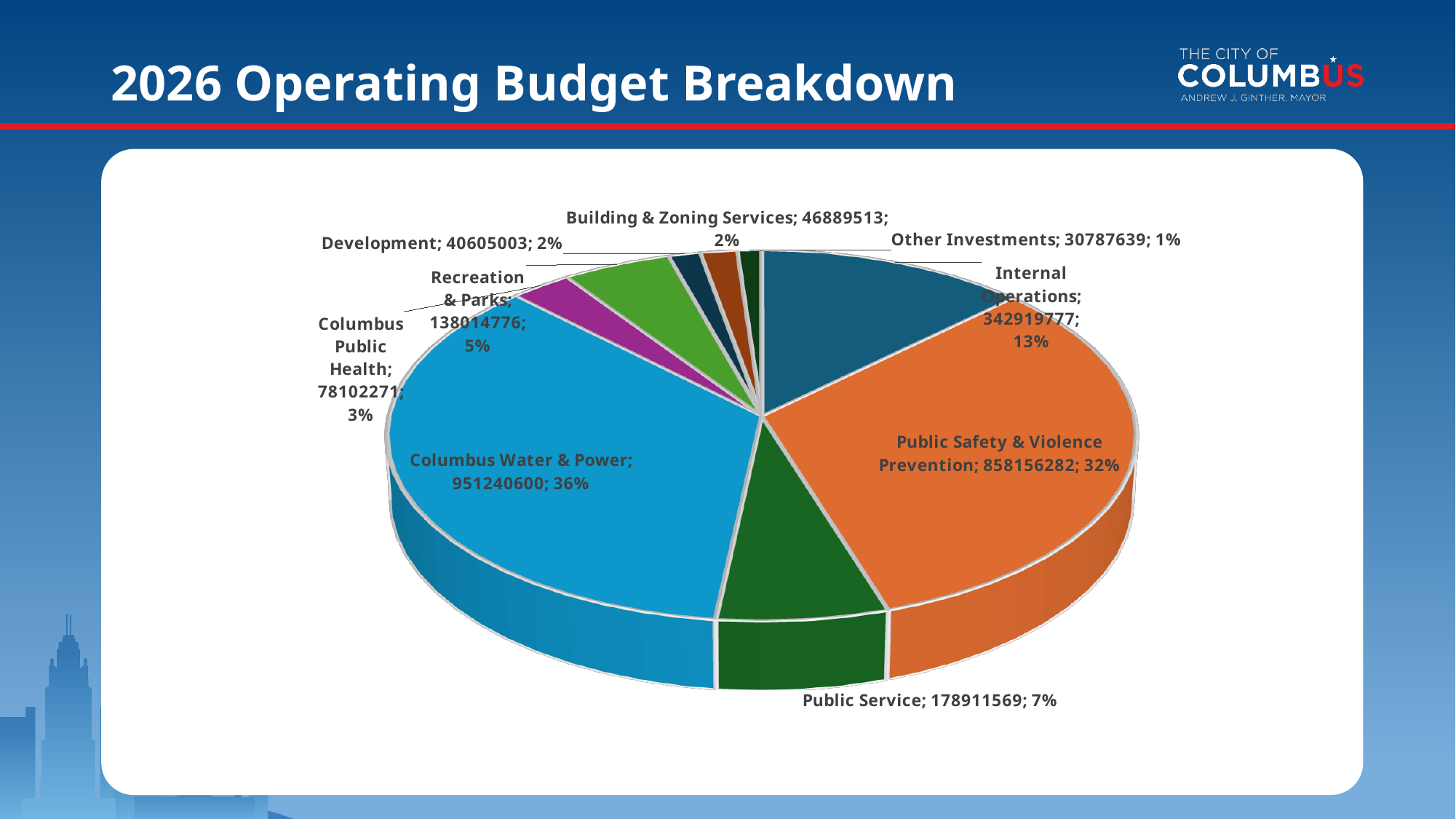
What is the value for Public Safety & Violence Prevention? 858156282 What kind of chart is shown on the slide? Pie chart What is the value for Columbus Water & Power? 951240600 What is the value for Public Service? 178911569 Which category has the largest share of the pie? Columbus Water & Power How many categories (slices) does the pie chart show? 9 What is the value for Internal Operations? 342919777 Which is larger, the value for Development or the value for Building & Zoning Services? Building & Zoning Services Which category has the smallest share of the pie? Other Investments What share of the pie does Columbus Public Health represent? 3% What is the difference between the values for Columbus Water & Power and Public Safety & Violence Prevention? 93084318 What share of the pie does Recreation & Parks represent? 5%